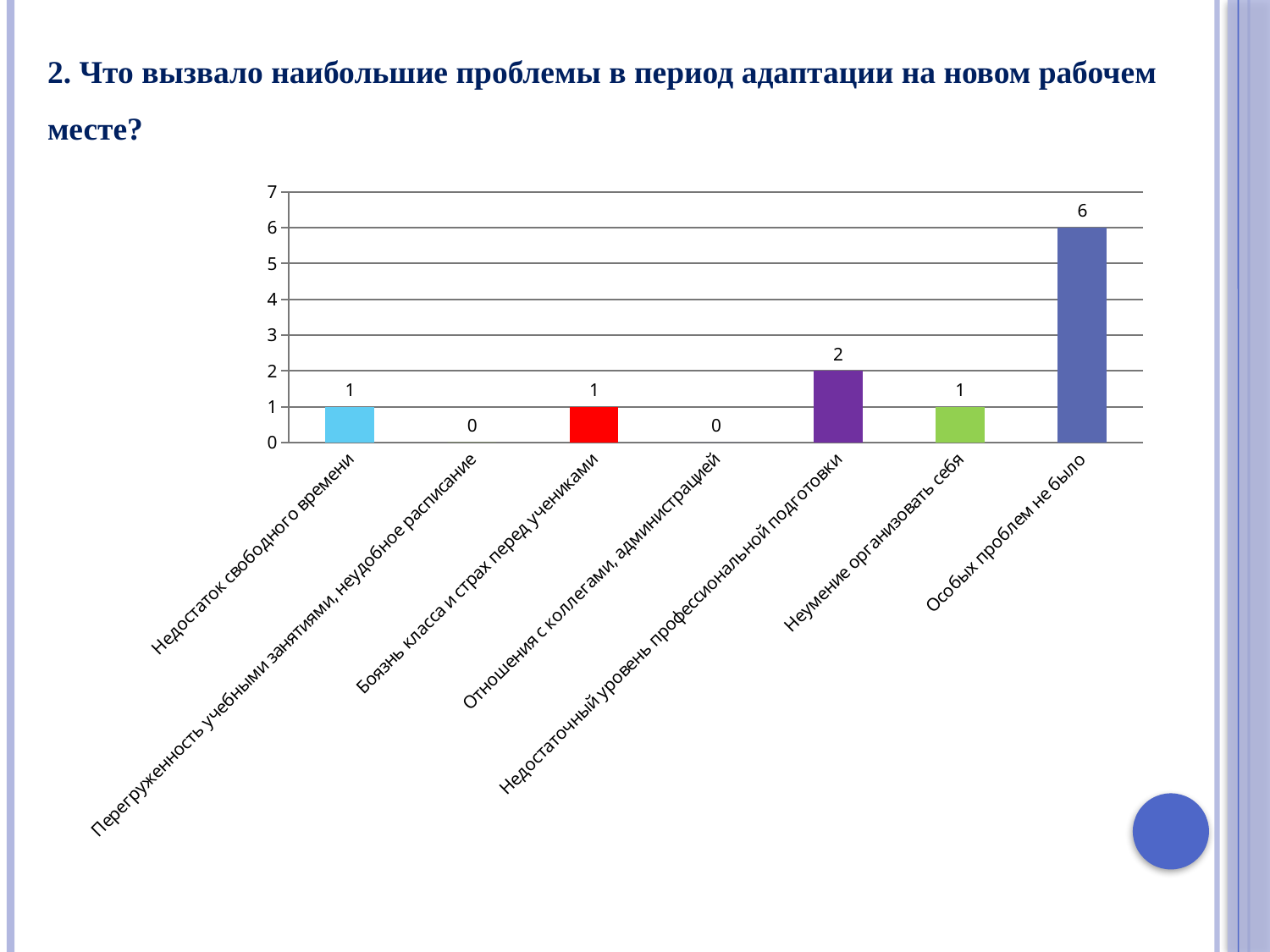
What value is shown for "Перегруженность учебными занятиями, неудобное расписание"? 0 What is the difference between the values for "Особых проблем не было" and "Недостаточный уровень профессиональной подготовки"? 4 What kind of chart is shown on the slide? Bar chart What is the maximum value shown on the vertical axis? 7 What value is shown for "Особых проблем не было"? 6 Which category has the highest value? Особых проблем не было How many categories are shown on the x axis? 7 What value is shown for "Неумение организовать себя"? 1 What value is shown for "Недостаточный уровень профессиональной подготовки"? 2 What colour is the bar for "Боязнь класса и страх перед учениками"? Red How many categories have a value of 0? 2 Which is larger: the value for "Боязнь класса и страх перед учениками" or the value for "Недостаточный уровень профессиональной подготовки"? Недостаточный уровень профессиональной подготовки